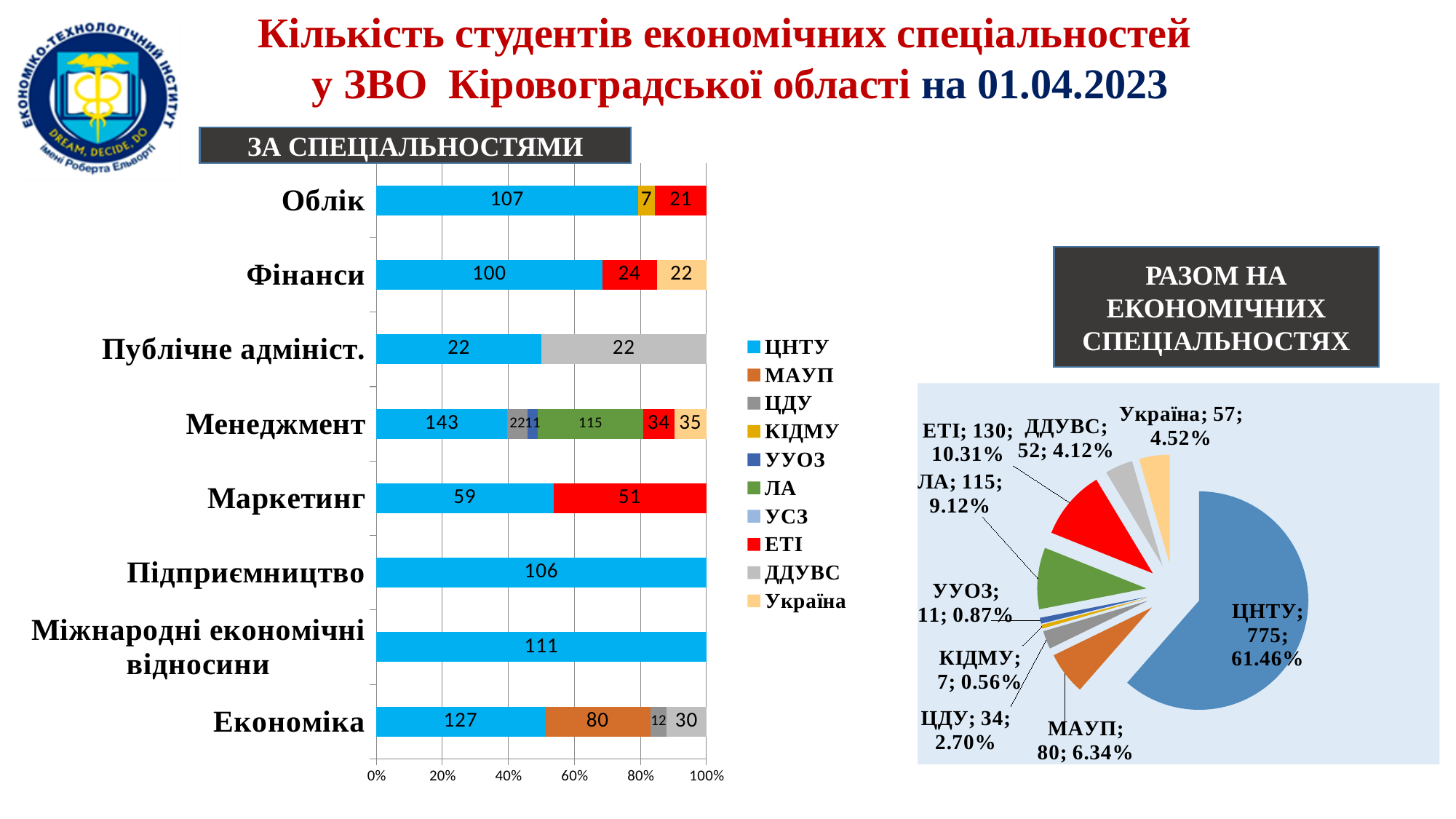
In the pie chart 'РАЗОМ НА ЕКОНОМІЧНИХ СПЕЦІАЛЬНОСТЯХ', what share of the total does ЕТІ have? 10.31% In the bar chart 'ЗА СПЕЦІАЛЬНОСТЯМИ', what is the value for ЦНТУ in the Облік category? 107 What kind of chart is the chart titled 'ЗА СПЕЦІАЛЬНОСТЯМИ'? Stacked bar chart In the bar chart 'ЗА СПЕЦІАЛЬНОСТЯМИ', what is the total number of students in the Облік category? 135 In the pie chart 'РАЗОМ НА ЕКОНОМІЧНИХ СПЕЦІАЛЬНОСТЯХ', which institution has the smallest slice? КІДМУ In the bar chart 'ЗА СПЕЦІАЛЬНОСТЯМИ', what is the difference between the ЦНТУ value for Маркетинг and the ЕТІ value for Маркетинг? 8 In the pie chart 'РАЗОМ НА ЕКОНОМІЧНИХ СПЕЦІАЛЬНОСТЯХ', which institution has the largest slice? ЦНТУ In the bar chart 'ЗА СПЕЦІАЛЬНОСТЯМИ', which is larger: the ЦНТУ value for Підприємництво or the ЦНТУ value for Міжнародні економічні відносини? Міжнародні економічні відносини In the bar chart 'ЗА СПЕЦІАЛЬНОСТЯМИ', how many series does the legend list? 10 In the bar chart 'ЗА СПЕЦІАЛЬНОСТЯМИ', how many specialty categories are shown? 8 In the bar chart 'ЗА СПЕЦІАЛЬНОСТЯМИ', what is the value for МАУП in the Економіка category? 80 In the bar chart 'ЗА СПЕЦІАЛЬНОСТЯМИ', what is the value for ЛА in the Менеджмент category? 115